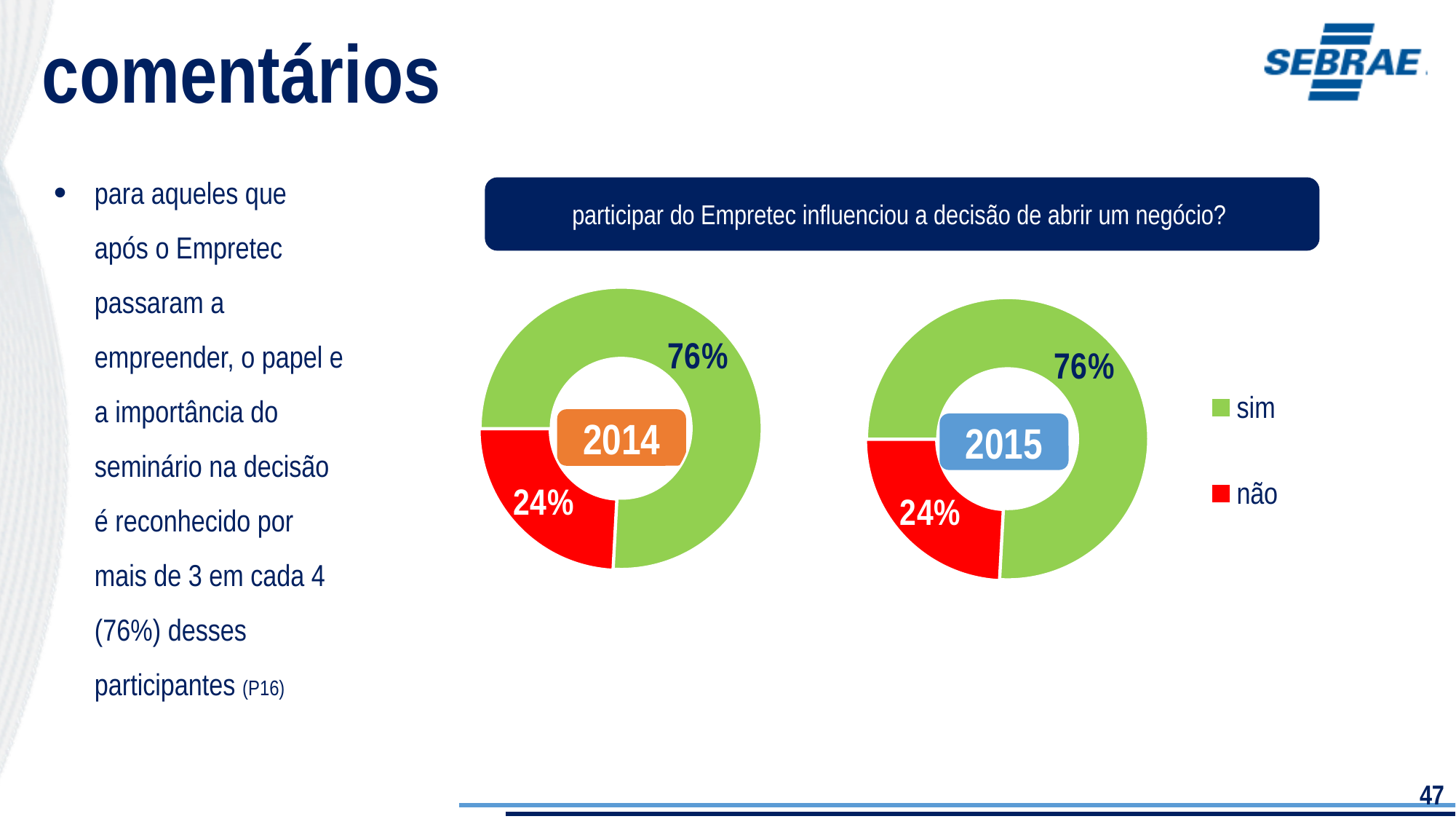
What kind of chart is used for the 2014 data? doughnut chart In the 2015 chart, is the share for "sim" larger or smaller than the share for "não"? larger In the 2014 chart, which response has the largest share? sim Which colour represents "não" in the charts? red In the 2014 chart, what is the difference in percentage points between "sim" and "não"? 52 In the 2014 chart, what percentage answered "sim"? 76% What question is shown in the title box above the charts? participar do Empretec influenciou a decisão de abrir um negócio? In the 2015 chart, which response has the smallest share? não In the 2015 chart, what percentage answered "sim"? 76% How many categories does the legend list? 2 In the 2015 chart, what percentage answered "não"? 24% In the 2014 chart, what percentage answered "não"? 24%